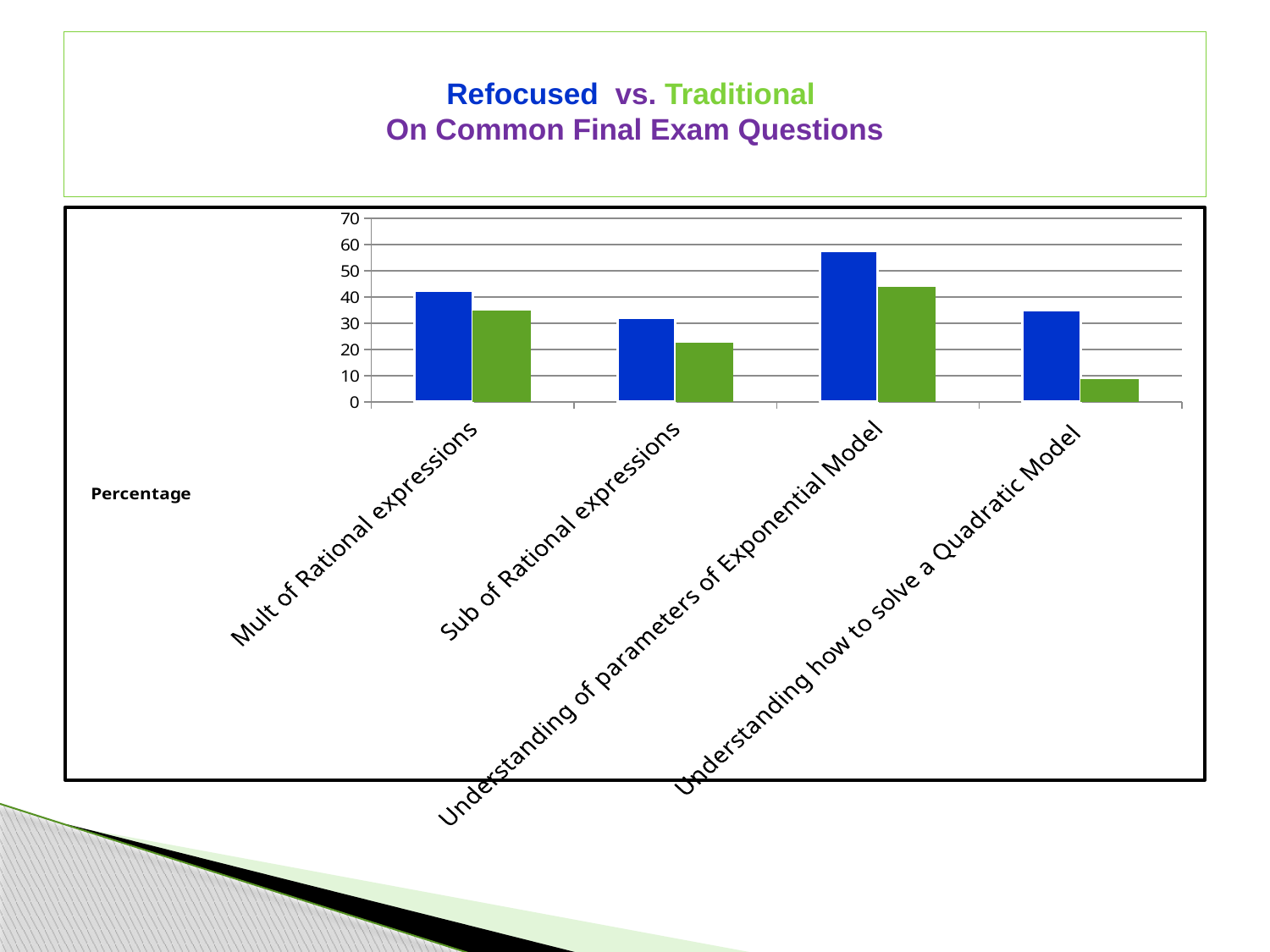
Which category has the tallest blue (Refocused) bar? Understanding of parameters of Exponential Model What label is shown for the vertical axis of the chart? Percentage Is the green (Traditional) value for Mult of Rational expressions greater or less than 30? greater Which green (Traditional) bar is taller, Mult of Rational expressions or Sub of Rational expressions? Mult of Rational expressions Is the green (Traditional) value for Understanding how to solve a Quadratic Model greater or less than 20? less For Sub of Rational expressions, which bar is taller, the blue (Refocused) or the green (Traditional)? blue (Refocused) Is the blue (Refocused) value for Understanding of parameters of Exponential Model greater or less than 50? greater Which category has the shortest green (Traditional) bar? Understanding how to solve a Quadratic Model Which category has the tallest green (Traditional) bar? Understanding of parameters of Exponential Model What kind of chart is shown on the slide? bar chart How many categories are shown on the x axis of the chart? 4